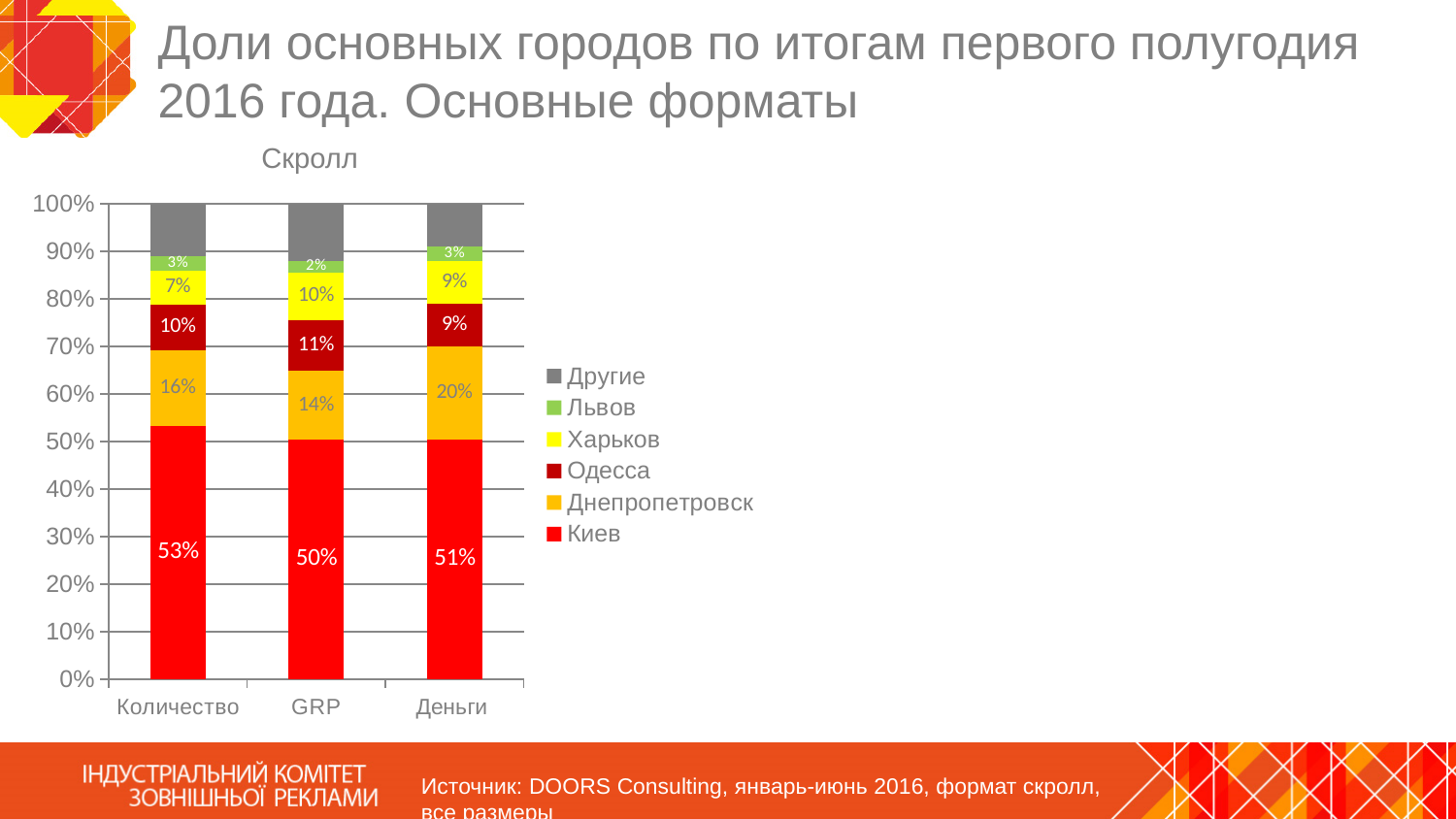
What is the value for Львов in the GRP bar? 2% What is the value for Киев in the Количество bar? 53% How many categories are shown on the x axis? 3 What is the value for Харьков in the Количество bar? 7% Which category has the lowest value for Днепропетровск? GRP What is the difference between the Днепропетровск values for Деньги and GRP? 6% What is the value for Одесса in the GRP bar? 11% Which is larger: Харьков in GRP or Харьков in Количество? Харьков in GRP How many series does the legend list? 6 What kind of chart is shown? Stacked bar chart What is the value for Днепропетровск in the Деньги bar? 20% Which category has the highest value for Киев? Количество